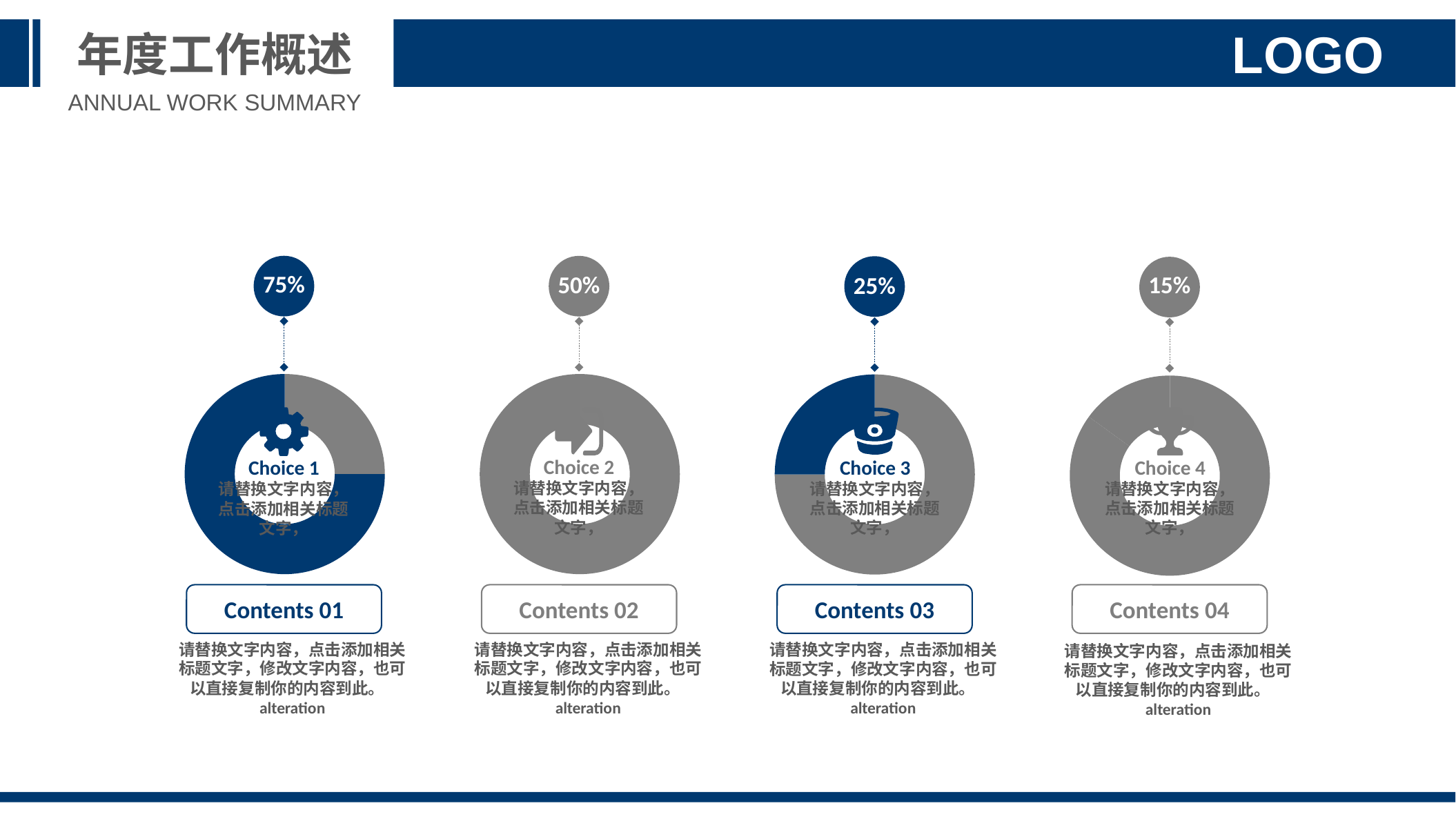
How many donut charts are shown on the slide? 4 Which has a larger percentage, Choice 2 or Choice 3? Choice 2 What percentage is shown above the Choice 2 donut chart? 50% What colour is the filled 75% portion of the Choice 1 donut chart? Dark blue Which choice has the lowest percentage among the four donut charts? Choice 4 Which choice has the highest percentage among the four donut charts? Choice 1 What percentage is shown above the Choice 3 donut chart? 25% What percentage is shown above the Choice 4 donut chart? 15% What is the difference between the percentages for Choice 2 and Choice 4? 35% What percentage is shown above the Choice 1 donut chart? 75% What is the difference between the percentages for Choice 1 and Choice 3? 50% What kind of chart is used to show each choice's percentage? Donut chart